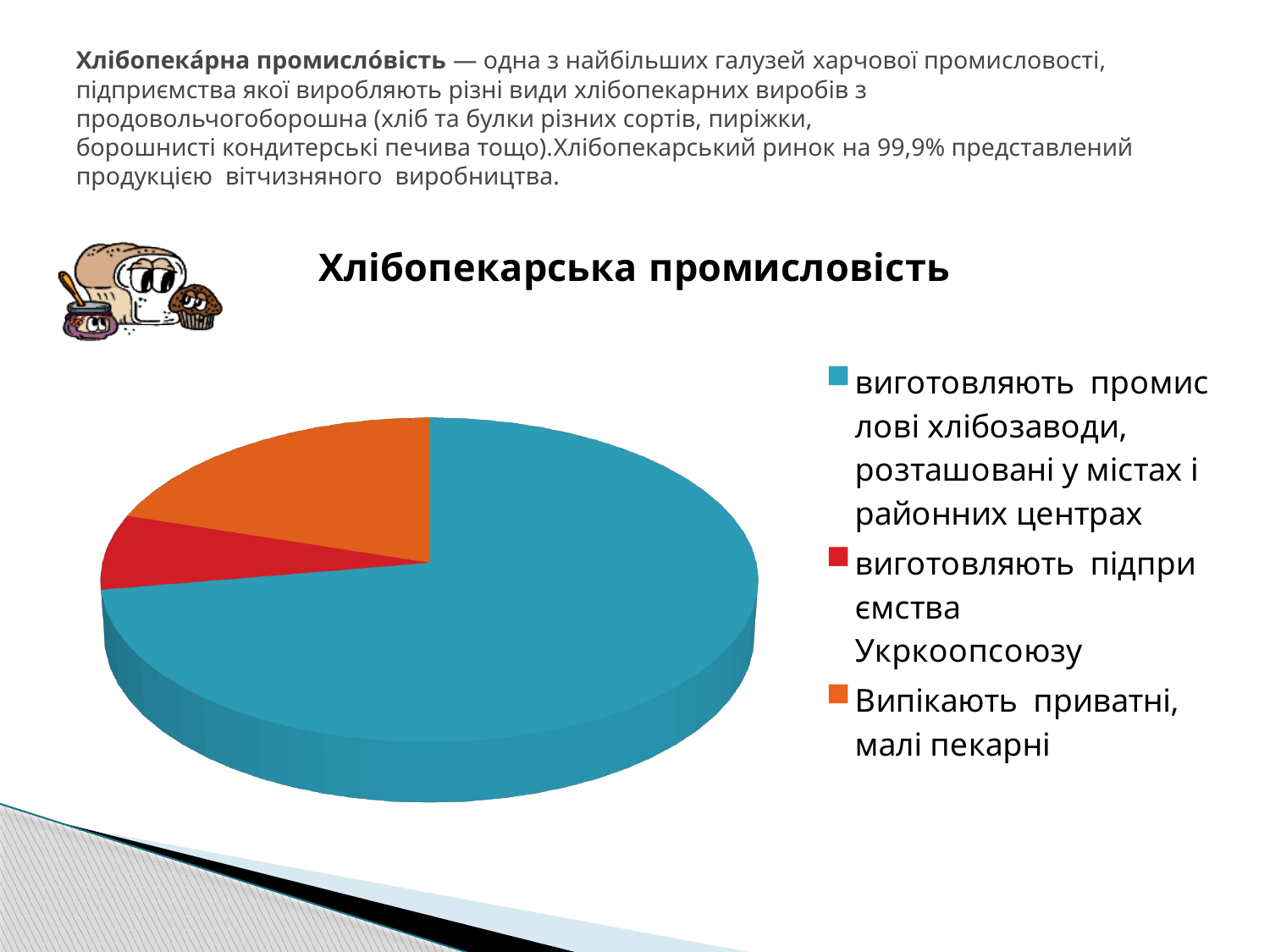
What colour is the slice for "Випікають приватні, малі пекарні"? orange Which category has the largest slice of the pie? виготовляють промислові хлібозаводи, розташовані у містах і районних центрах How many entries does the chart legend list? 3 What kind of chart is shown on the slide? pie chart Which slice is larger: "виготовляють промислові хлібозаводи, розташовані у містах і районних центрах" or "Випікають приватні, малі пекарні"? виготовляють промислові хлібозаводи, розташовані у містах і районних центрах How many slices does the pie chart have? 3 What is the title of the chart? Хлібопекарська промисловість Which slice is larger: "Випікають приватні, малі пекарні" or "виготовляють підприємства Укркоопсоюзу"? Випікають приватні, малі пекарні Which category has the smallest slice of the pie? виготовляють підприємства Укркоопсоюзу